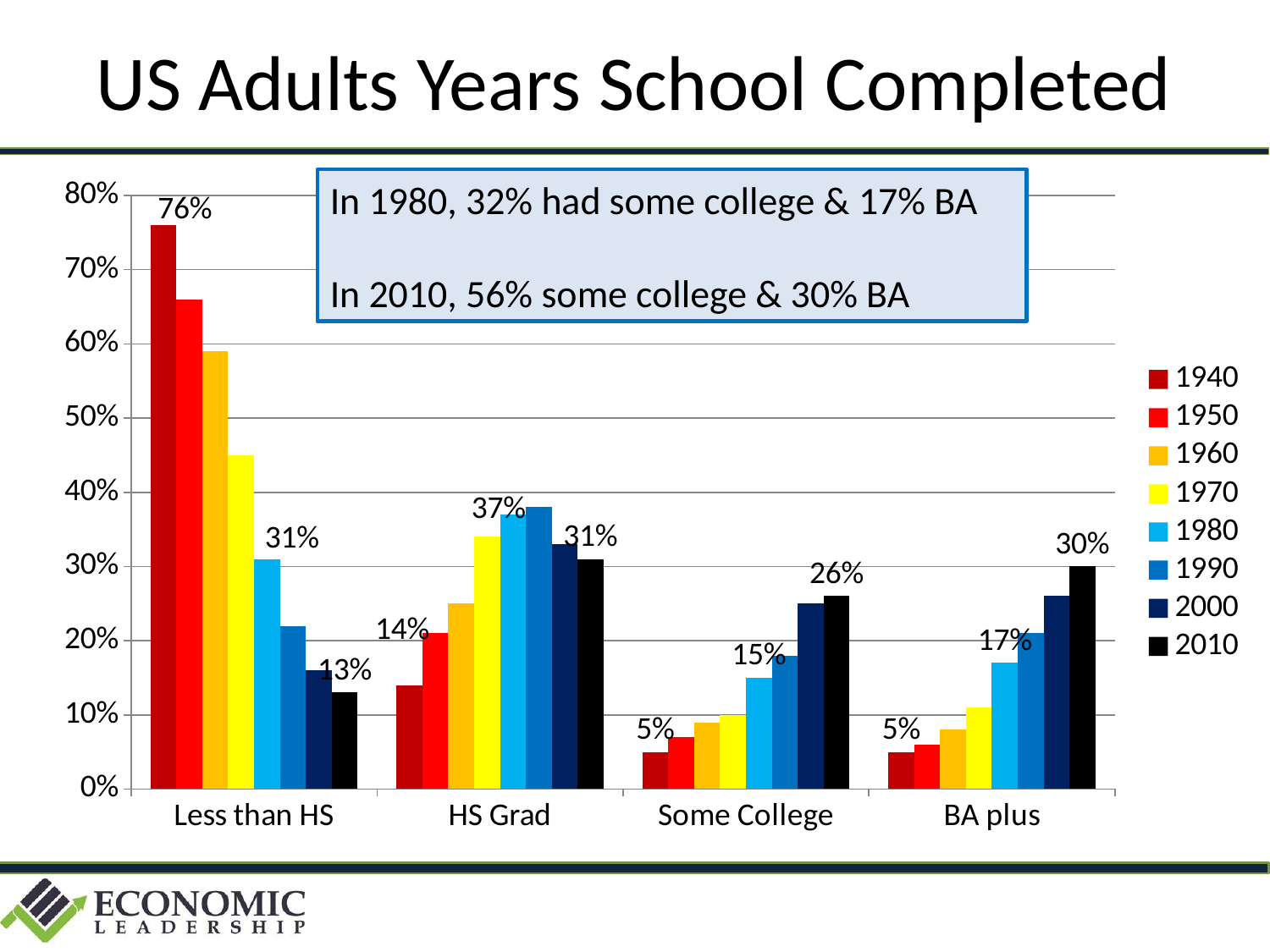
Which category has the highest value for 1940? Less than HS What is the value for 1940 in the Less than HS category? 76% What is the value for 2010 in the BA plus category? 30% How many education categories are shown on the x axis? 4 What is the value for 2010 in the Some College category? 26% Which category has the lowest value for 2010? Less than HS Is the value for 1950 in the Less than HS category greater or less than 60%? greater Do the values for the Less than HS category rise or fall from 1940 to 2010? fall For 1980, which is larger: Some College or BA plus? BA plus What is the value for 1980 in the HS Grad category? 37% How many series does the legend list? 8 By how many percentage points did the Less than HS share fall from 1940 to 2010? 63 percentage points